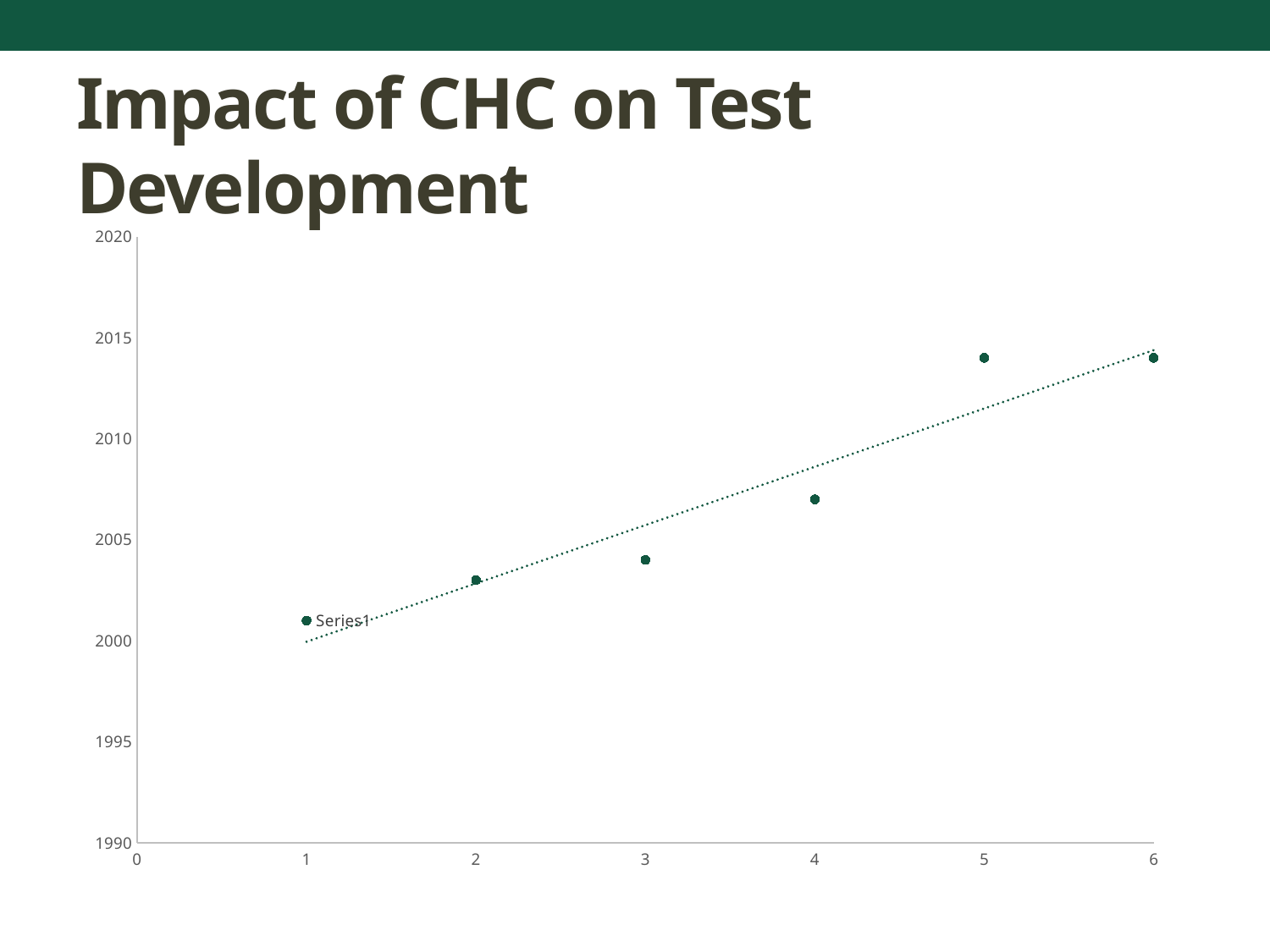
Is the value for x = 2 greater or less than 2005? less Is the value for x = 4 greater or less than 2005? greater How many data points are plotted on the chart? 6 Which x value has the lowest plotted point? 1 Is the value for x = 6 greater or less than 2015? less What is the title of the slide containing the chart? Impact of CHC on Test Development Do the plotted values rise or fall as the x value increases from 1 to 6? rise What is the name of the data series labelled on the chart? Series1 What kind of chart is shown on the slide? scatter chart Which has the larger value, the point at x = 4 or the point at x = 5? x = 5